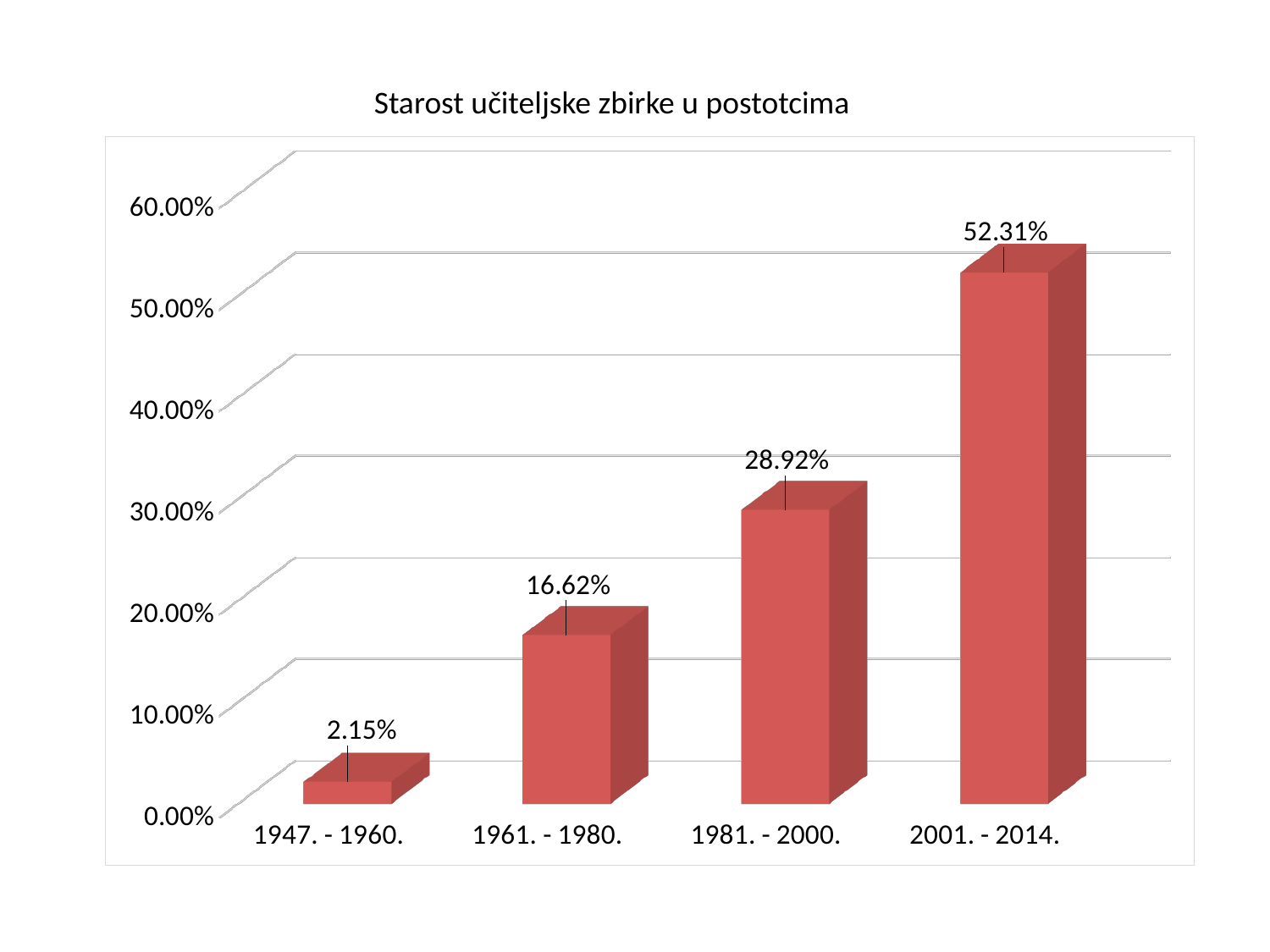
What is the value for 1981. - 2000.? 28.92% Do the values rise or fall from left to right along the x axis? Rise What is the difference between the values for 2001. - 2014. and 1981. - 2000.? 23.39% What is the title of the chart? Starost učiteljske zbirke u postotcima Which period has the highest value? 2001. - 2014. What is the value for 1947. - 1960.? 2.15% Which period has the lowest value? 1947. - 1960. What is the value for 2001. - 2014.? 52.31% What kind of chart is this? Bar chart What is the value for 1961. - 1980.? 16.62% How many periods are shown on the x axis? 4 Which is larger, the value for 1961. - 1980. or the value for 1981. - 2000.? 1981. - 2000.